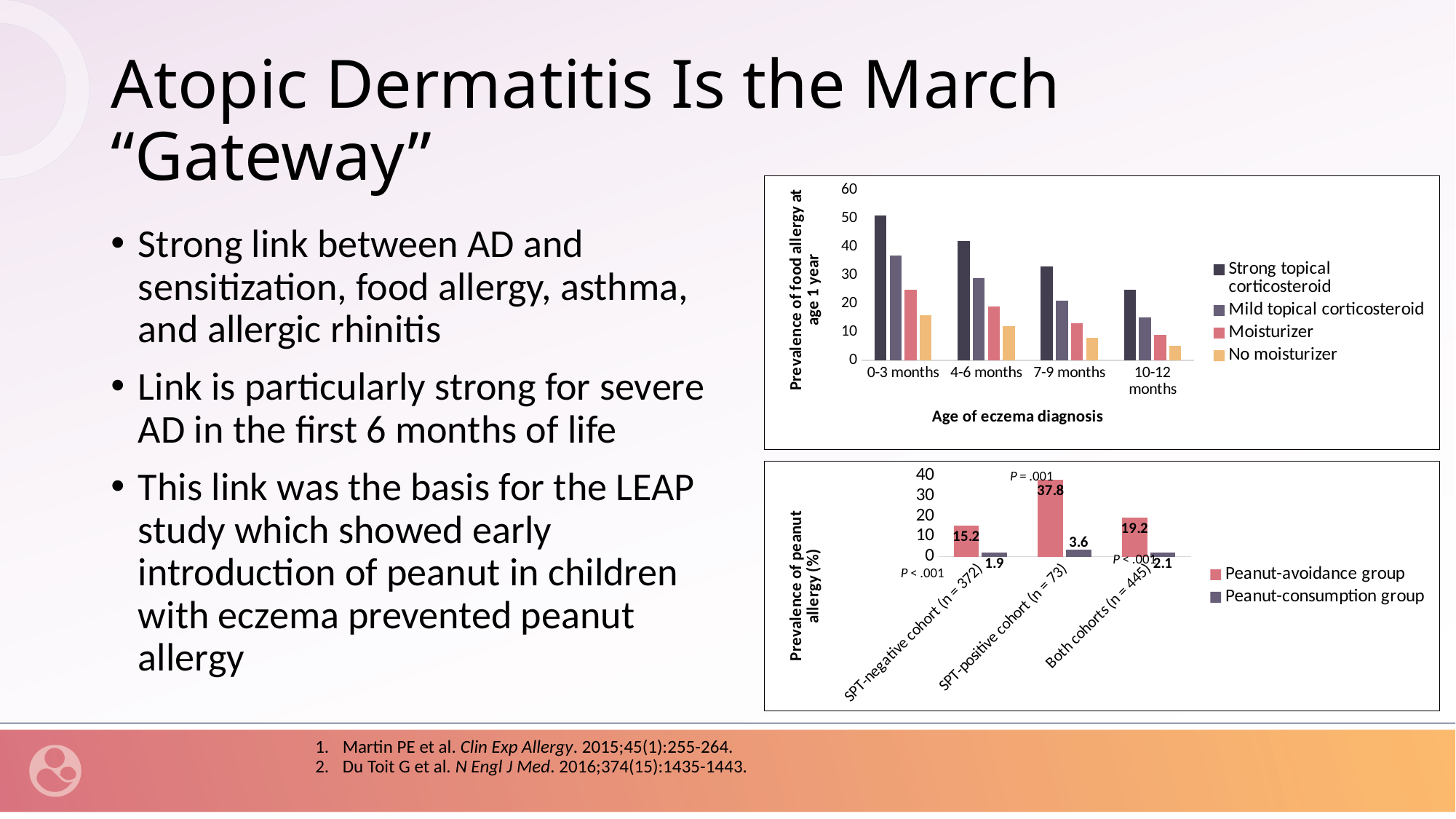
In the bottom chart (prevalence of peanut allergy), what is the value for the peanut-consumption group in the SPT-negative cohort? 1.9 In the top chart (prevalence of food allergy at age 1 year), how many series does the legend list? 4 In the top chart (prevalence of food allergy at age 1 year), is the value for Strong topical corticosteroid at 0-3 months greater or less than 40? greater In the bottom chart (prevalence of peanut allergy), which cohort has the lowest value for the peanut-consumption group? SPT-negative cohort (n = 372) What kind of chart is the top chart (prevalence of food allergy at age 1 year)? bar chart In the bottom chart (prevalence of peanut allergy), what is the value for the peanut-avoidance group in the SPT-positive cohort? 37.8 In the bottom chart (prevalence of peanut allergy), which cohort has the highest value for the peanut-avoidance group? SPT-positive cohort (n = 73) In the top chart (prevalence of food allergy at age 1 year), how many age-of-eczema-diagnosis categories are shown on the x axis? 4 In the top chart (prevalence of food allergy at age 1 year), do the values for Strong topical corticosteroid rise or fall as the age of eczema diagnosis increases? fall In the bottom chart (prevalence of peanut allergy), what is the difference between the peanut-avoidance and peanut-consumption groups in the SPT-positive cohort? 34.2 In the bottom chart (prevalence of peanut allergy), how many series does the legend list? 2 In the bottom chart (prevalence of peanut allergy), what is the value for the peanut-avoidance group for both cohorts? 19.2